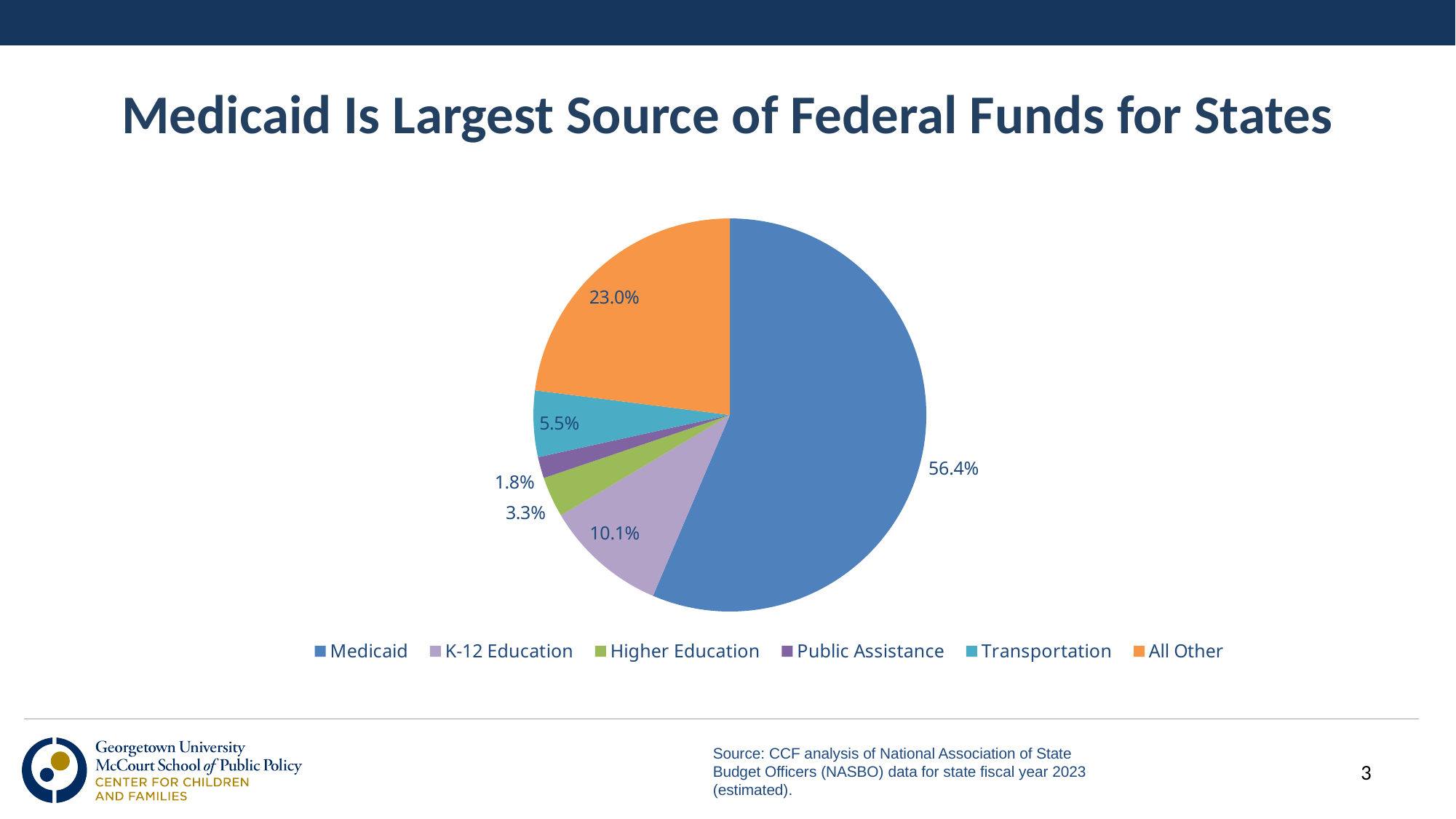
Which category has the largest slice of the pie? Medicaid What colour is the All Other slice? Orange What percentage is shown for Higher Education? 3.3% What kind of chart is shown on the slide? Pie chart What is the difference in percentage points between Medicaid and All Other? 33.4 What percentage is shown for K-12 Education? 10.1% Which category has the smallest slice of the pie? Public Assistance How many categories does the pie chart show? 6 What percentage is shown for Transportation? 5.5% What share of federal funds for states goes to Medicaid? 56.4% What percentage is shown for Public Assistance? 1.8% Which is larger, the share for K-12 Education or the share for Transportation? K-12 Education